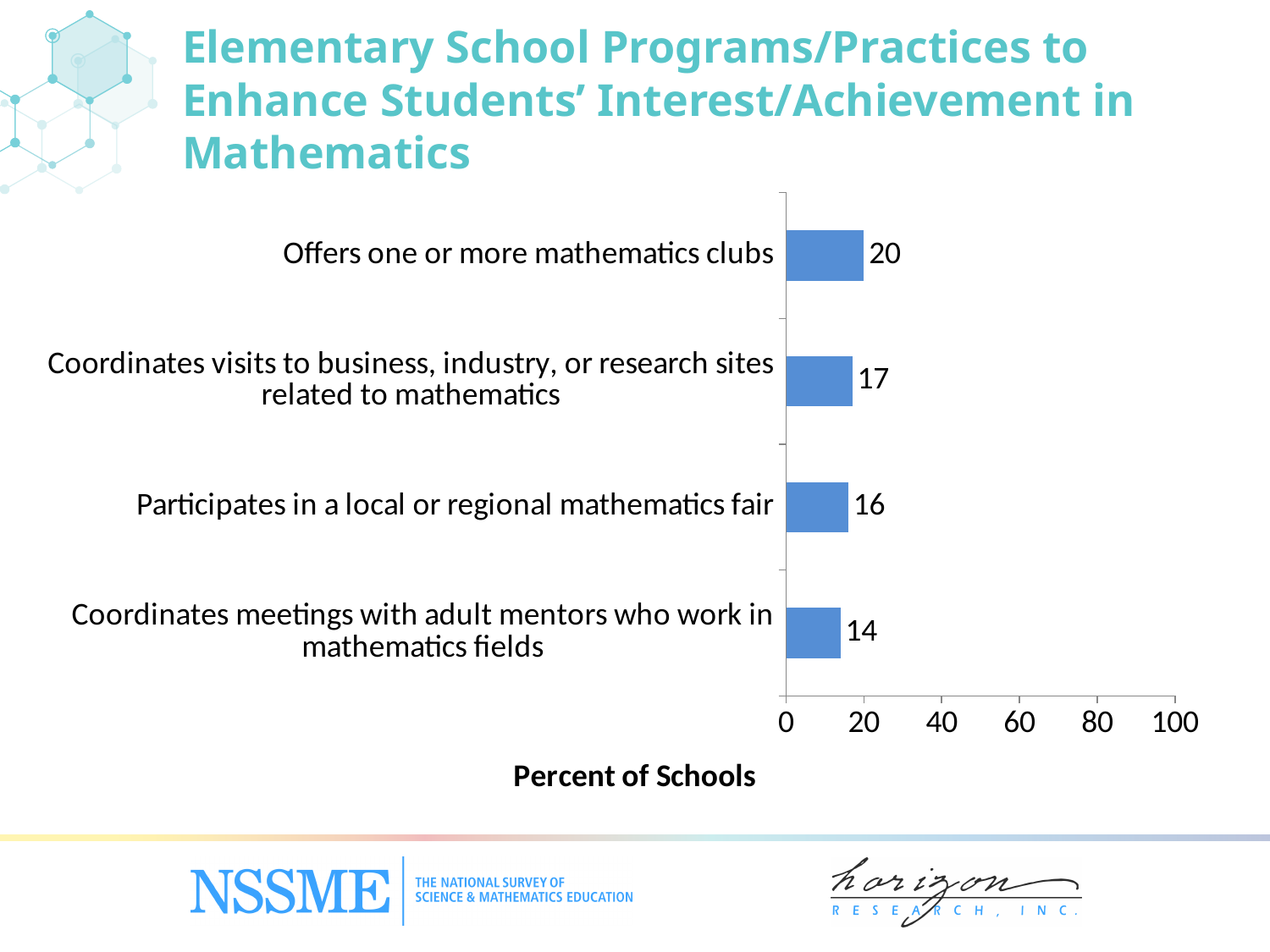
What kind of chart is shown on the slide? Bar chart Is the value for participating in a local or regional mathematics fair greater or less than 20? less What is the difference in percent of schools between offering mathematics clubs and coordinating meetings with adult mentors? 6 What is the label of the horizontal axis? Percent of Schools Which program/practice has the highest percent of schools? Offers one or more mathematics clubs What percent of schools coordinate meetings with adult mentors who work in mathematics fields? 14 What percent of schools coordinate visits to business, industry, or research sites related to mathematics? 17 How many programs/practices are shown in the chart? 4 What percent of schools participate in a local or regional mathematics fair? 16 Which is larger: the percent of schools coordinating visits to business, industry, or research sites, or the percent participating in a local or regional mathematics fair? Coordinates visits to business, industry, or research sites related to mathematics Which program/practice has the lowest percent of schools? Coordinates meetings with adult mentors who work in mathematics fields What percent of schools offer one or more mathematics clubs? 20